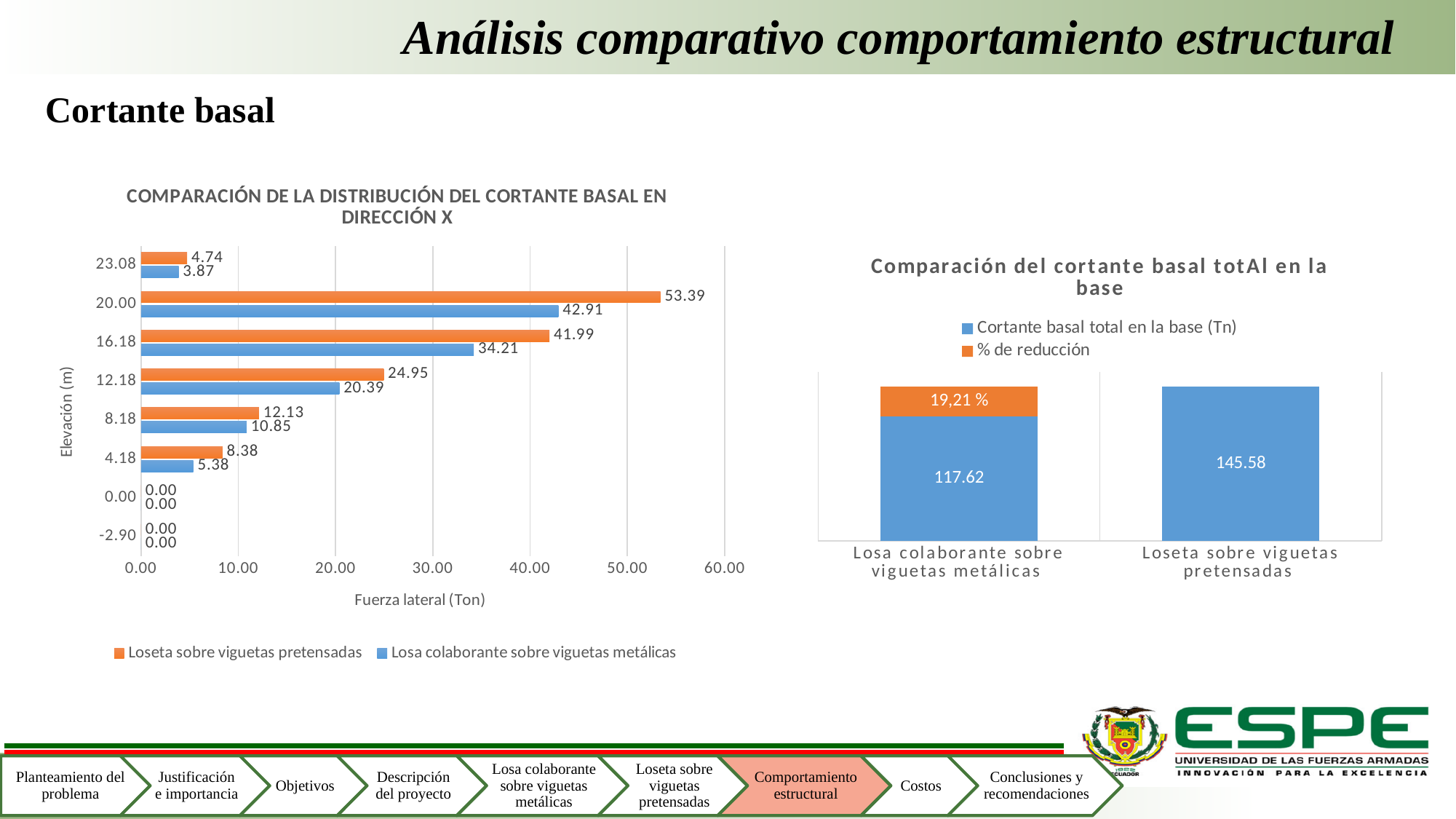
In the chart 'COMPARACIÓN DE LA DISTRIBUCIÓN DEL CORTANTE BASAL EN DIRECCIÓN X', what is the lateral force for 'Loseta sobre viguetas pretensadas' at elevation 20.00? 53.39 In the chart 'Comparación del cortante basal totAl en la base', what is the 'Cortante basal total en la base (Tn)' value for 'Loseta sobre viguetas pretensadas'? 145.58 In the chart 'COMPARACIÓN DE LA DISTRIBUCIÓN DEL CORTANTE BASAL EN DIRECCIÓN X', what is the label of the horizontal axis? Fuerza lateral (Ton) In the chart 'COMPARACIÓN DE LA DISTRIBUCIÓN DEL CORTANTE BASAL EN DIRECCIÓN X', at which elevation is the lateral force for 'Loseta sobre viguetas pretensadas' highest? 20.00 In the chart 'COMPARACIÓN DE LA DISTRIBUCIÓN DEL CORTANTE BASAL EN DIRECCIÓN X', which series has the larger value at elevation 8.18? Loseta sobre viguetas pretensadas In the chart 'COMPARACIÓN DE LA DISTRIBUCIÓN DEL CORTANTE BASAL EN DIRECCIÓN X', what is the lateral force for 'Losa colaborante sobre viguetas metálicas' at elevation 12.18? 20.39 What kind of chart is 'COMPARACIÓN DE LA DISTRIBUCIÓN DEL CORTANTE BASAL EN DIRECCIÓN X'? Bar chart In the chart 'COMPARACIÓN DE LA DISTRIBUCIÓN DEL CORTANTE BASAL EN DIRECCIÓN X', what is the difference between the two series at elevation 16.18? 7.78 In the chart 'COMPARACIÓN DE LA DISTRIBUCIÓN DEL CORTANTE BASAL EN DIRECCIÓN X', how many series does the legend list? 2 In the chart 'COMPARACIÓN DE LA DISTRIBUCIÓN DEL CORTANTE BASAL EN DIRECCIÓN X', how many elevation categories are shown on the vertical axis? 8 In the chart 'Comparación del cortante basal totAl en la base', what '% de reducción' is shown for 'Losa colaborante sobre viguetas metálicas'? 19,21 % In the chart 'Comparación del cortante basal totAl en la base', which category has the higher 'Cortante basal total en la base (Tn)' value? Loseta sobre viguetas pretensadas